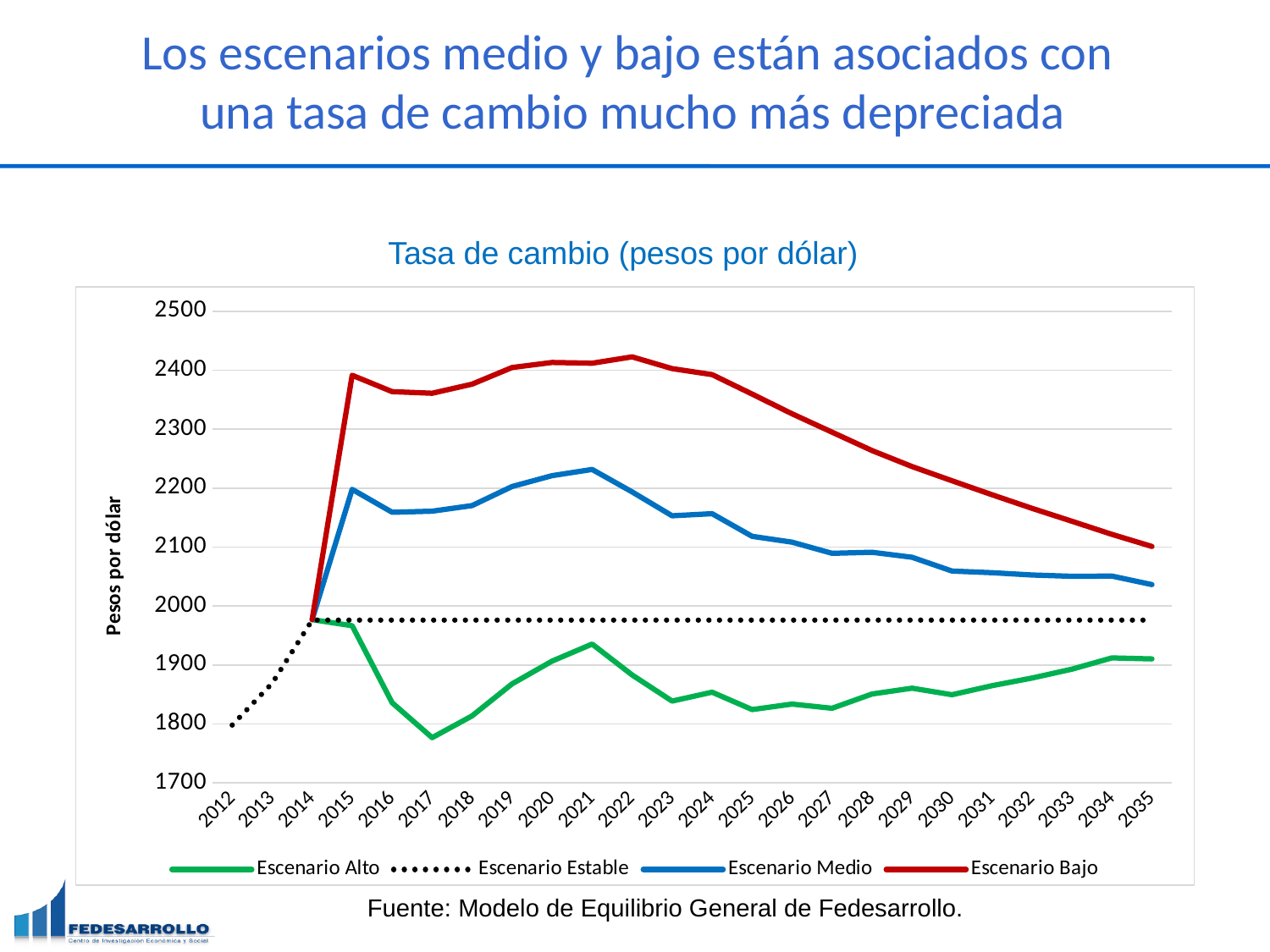
Is the value for Escenario Alto in 2017 greater or less than 1800? less Does the Escenario Bajo line rise or fall from 2022 to 2035? fall Is the value for Escenario Estable in 2030 greater or less than 2000? less What is the title of the chart? Tasa de cambio (pesos por dólar) How many series does the legend list? 4 In 2035, which is larger: Escenario Bajo or Escenario Medio? Escenario Bajo Is the value for Escenario Medio in 2035 greater or less than 2100? less What kind of chart is shown on the slide? line chart How many years are shown along the x axis? 24 Which scenario has the highest value in 2022? Escenario Bajo Which scenario has the lowest value in 2017? Escenario Alto